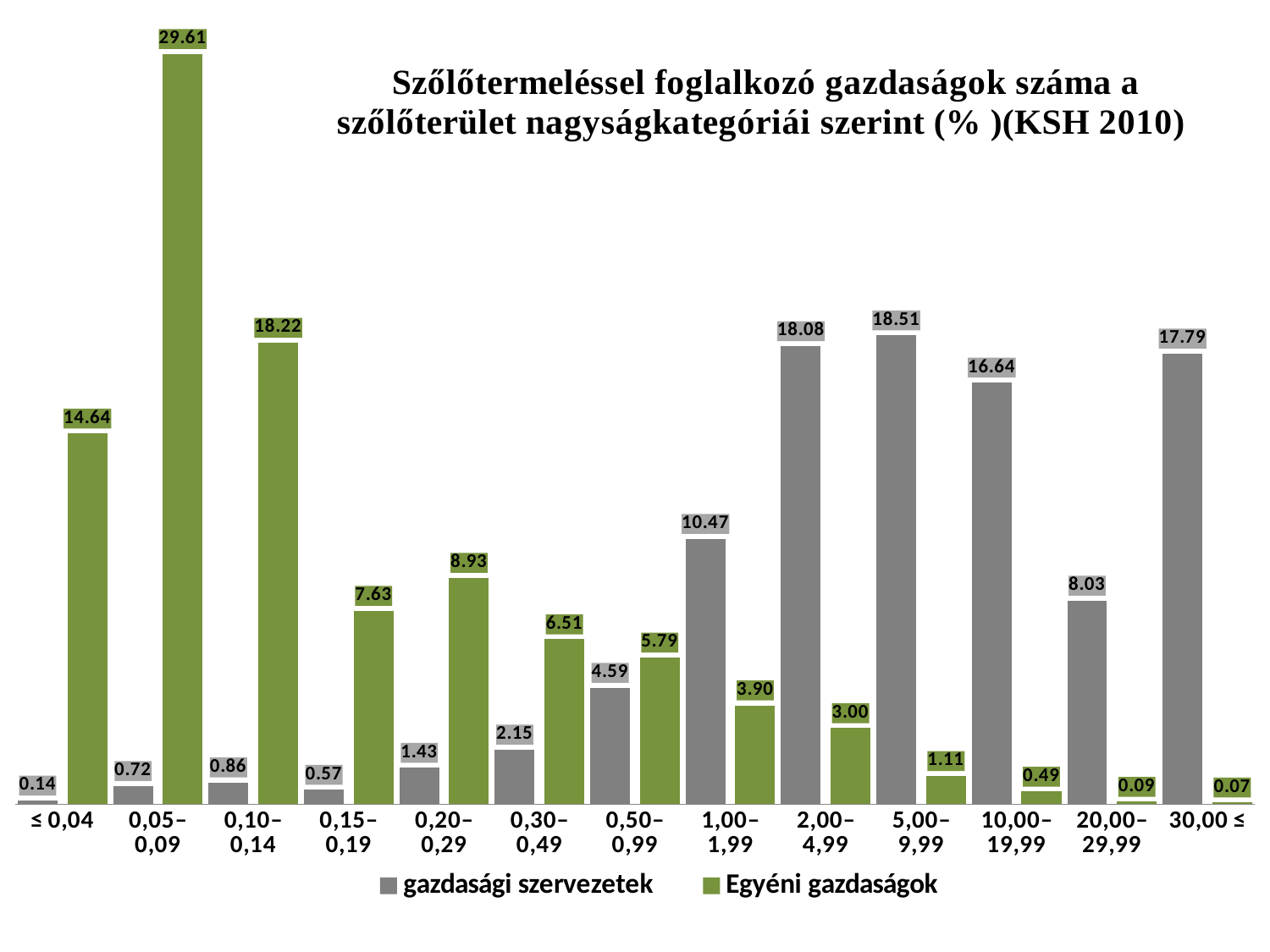
What is the value for Egyéni gazdaságok in the 0,05–0,09 category? 29.61 Which category has the highest value for Egyéni gazdaságok? 0,05–0,09 What is the value for gazdasági szervezetek in the 30,00 ≤ category? 17.79 What is the value for Egyéni gazdaságok in the 20,00–29,99 category? 0.09 In the 1,00–1,99 category, which series has the larger value? gazdasági szervezetek How many size categories are shown on the x axis? 13 What is the difference between the Egyéni gazdaságok values for 0,05–0,09 and ≤ 0,04? 14.97 Which category has the lowest value for gazdasági szervezetek? ≤ 0,04 What is the value for gazdasági szervezetek in the 5,00–9,99 category? 18.51 How many series does the legend list? 2 What kind of chart is shown on the slide? bar chart Which series is shown in green? Egyéni gazdaságok